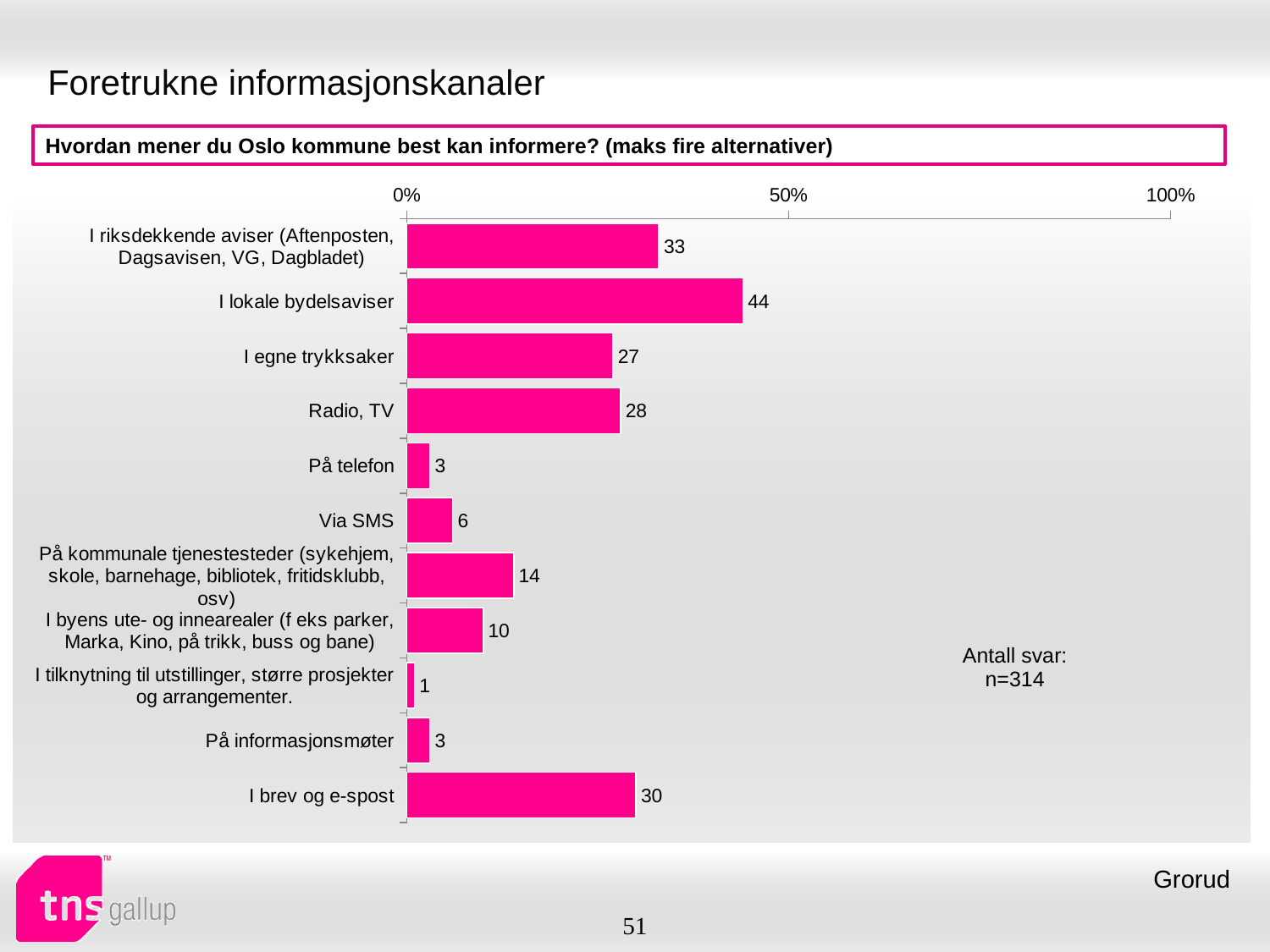
Which category has the highest value? I lokale bydelsaviser What is the difference between the values for "I lokale bydelsaviser" and "I riksdekkende aviser (Aftenposten, Dagsavisen, VG, Dagbladet)"? 11 What is the value for "Radio, TV"? 28 What is the value for "På kommunale tjenestesteder (sykehjem, skole, barnehage, bibliotek, fritidsklubb, osv)"? 14 What is the value for "I lokale bydelsaviser"? 44 What is the number of responses (Antall svar) stated on the slide? n=314 How many categories are shown in the chart? 11 What kind of chart is shown on the slide? bar chart What is the value for "I brev og e-spost"? 30 Which is larger, the value for "Via SMS" or the value for "På telefon"? Via SMS Which category has the lowest value? I tilknytning til utstillinger, større prosjekter og arrangementer. Is the value for "I lokale bydelsaviser" greater or less than 50%? less